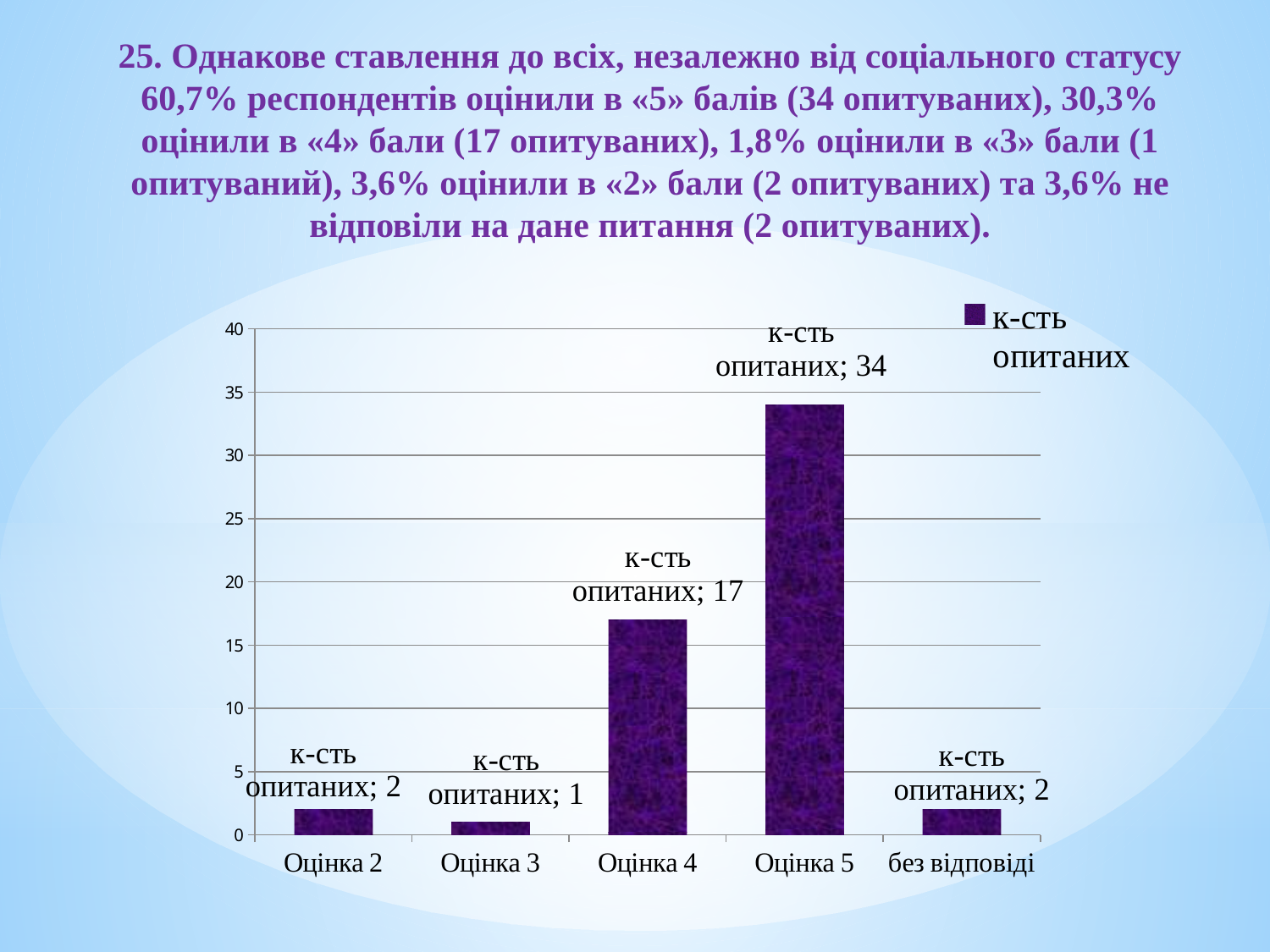
What is the value for Оцінка 5? 34 How many categories are shown on the x axis? 5 What is the value for Оцінка 4? 17 Is the value for Оцінка 5 greater or less than 30? greater Which category has the lowest value? Оцінка 3 What is the value for Оцінка 3? 1 What is the value for без відповіді? 2 Which is larger, the value for Оцінка 2 or the value for Оцінка 3? Оцінка 2 Which category has the highest value? Оцінка 5 What is the difference between the values for Оцінка 5 and Оцінка 4? 17 What kind of chart is shown on the slide? bar chart What series name does the legend show? к-сть опитаних